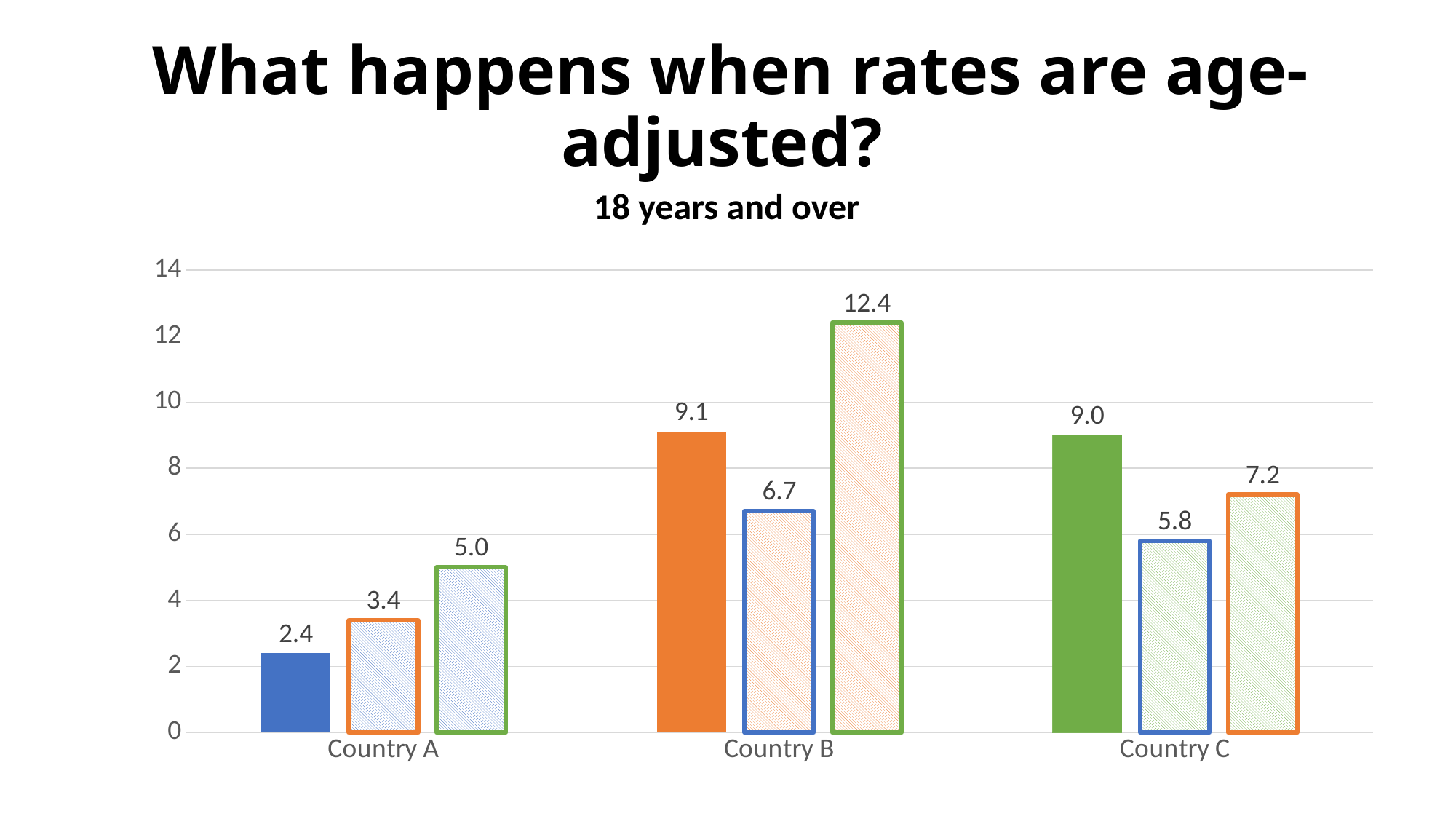
What is the difference between the third bar and the first bar for Country B? 3.3 What is the value of the first (solid) bar for Country A? 2.4 How many countries are shown on the x axis? 3 What kind of chart is shown on the slide? Bar chart Which bar on the chart has the highest value? The third bar for Country B (12.4) What is the value of the first (solid) bar for Country C? 9.0 Which is larger: the first bar for Country B or the first bar for Country C? The first bar for Country B (9.1) What is the subtitle shown above the chart? 18 years and over What is the value of the third bar for Country B? 12.4 What is the difference between the third bar for Country A and the first bar for Country A? 2.6 What is the value of the second bar for Country C? 5.8 Which bar on the chart has the lowest value? The first bar for Country A (2.4)